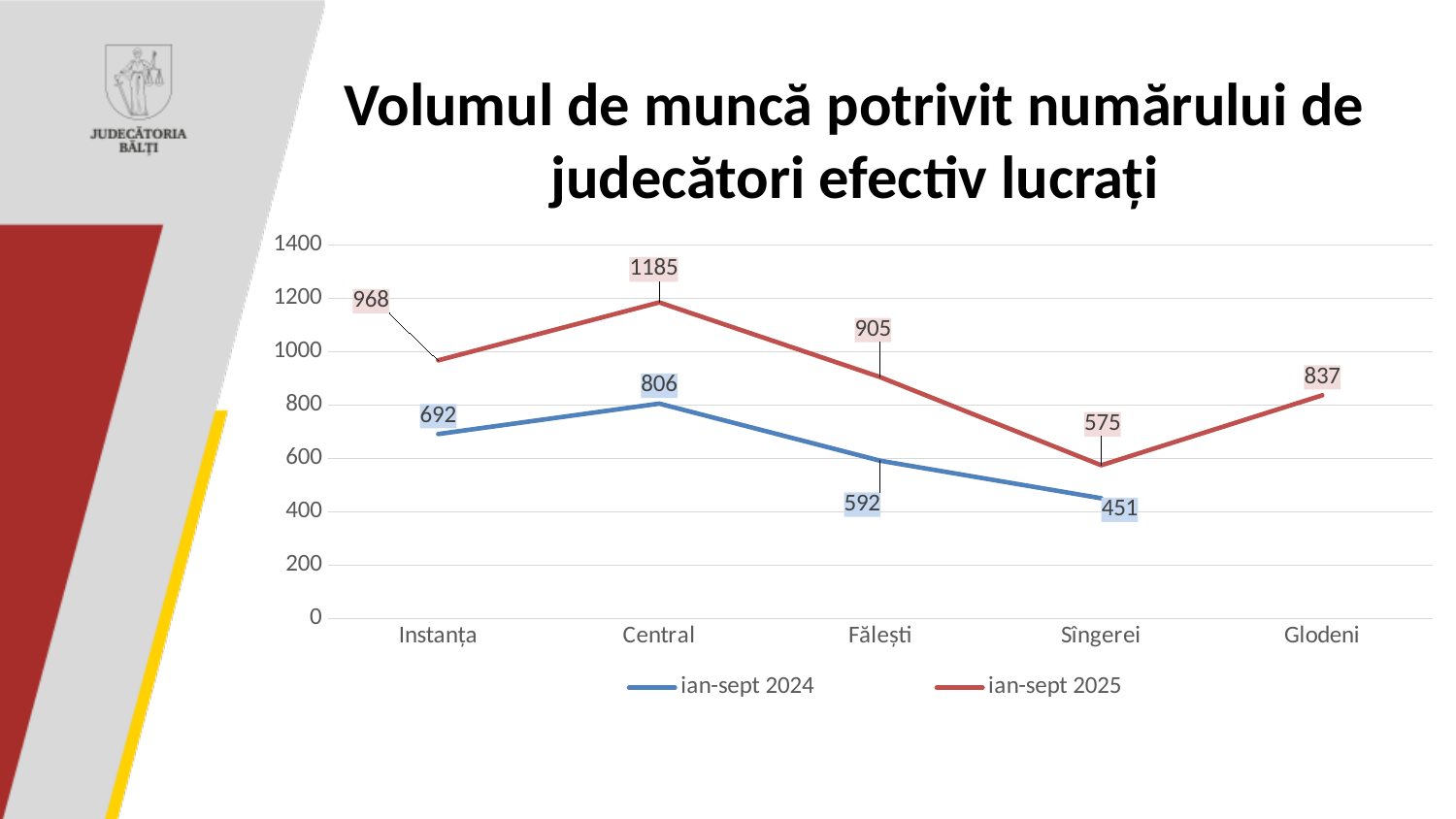
What is the value for Glodeni in the ian-sept 2025 series? 837 What kind of chart is shown on the slide? line chart Which is larger for Fălești: the ian-sept 2024 value or the ian-sept 2025 value? ian-sept 2025 Which category has the lowest value in the ian-sept 2024 series? Sîngerei How many series does the legend list? 2 Which category has the highest value in the ian-sept 2025 series? Central How many categories are shown on the x axis? 5 What is the value for Central in the ian-sept 2025 series? 1185 What is the value for Fălești in the ian-sept 2024 series? 592 Is the ian-sept 2025 value for Sîngerei greater or less than 600? less What is the difference between the ian-sept 2025 and ian-sept 2024 values for Instanța? 276 What is the value for Sîngerei in the ian-sept 2024 series? 451